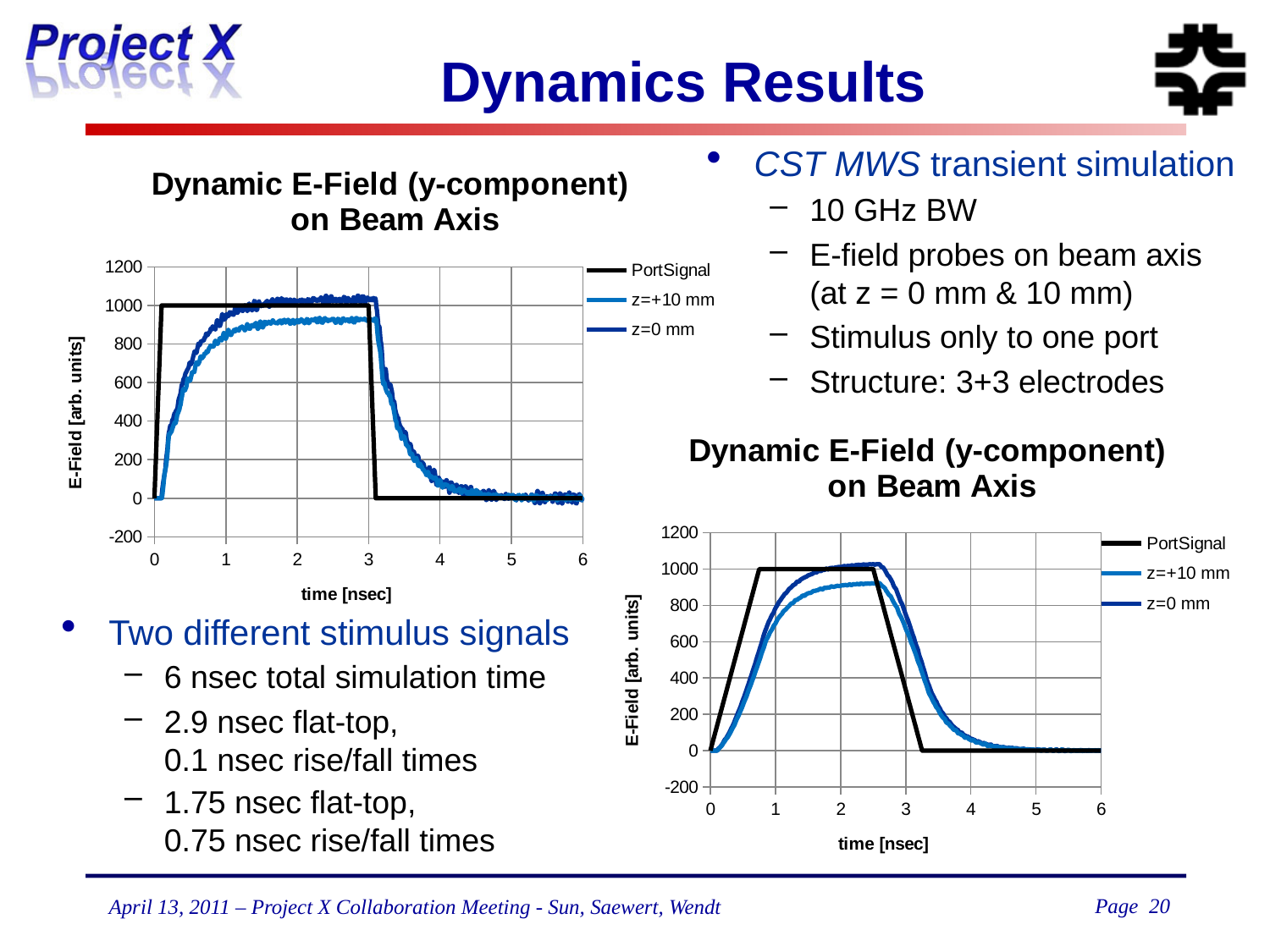
In the left chart, is the peak value of the z=+10 mm series greater or less than 1000? less How many series does the legend of the left chart list? 3 In the right chart, does the z=+10 mm series rise or fall between 0 and 2 nsec? rise What type of chart is the left chart titled 'Dynamic E-Field (y-component) on Beam Axis'? line chart In the right chart, is the value of the z=+10 mm series at 5 nsec greater or less than 200? less What are the legend entries of the right chart? PortSignal, z=+10 mm, z=0 mm What is the y-axis label of the left chart? E-Field [arb. units] In the right chart, is the peak value of the z=0 mm series greater or less than 800? greater In the left chart, does the z=0 mm series rise or fall between 3 and 5 nsec? fall In the left chart, at time 2 nsec, which series is higher: z=0 mm or z=+10 mm? z=0 mm In the right chart, which series reaches the highest peak value? z=0 mm In the left chart, at what value does the flat top of the PortSignal series sit? 1000